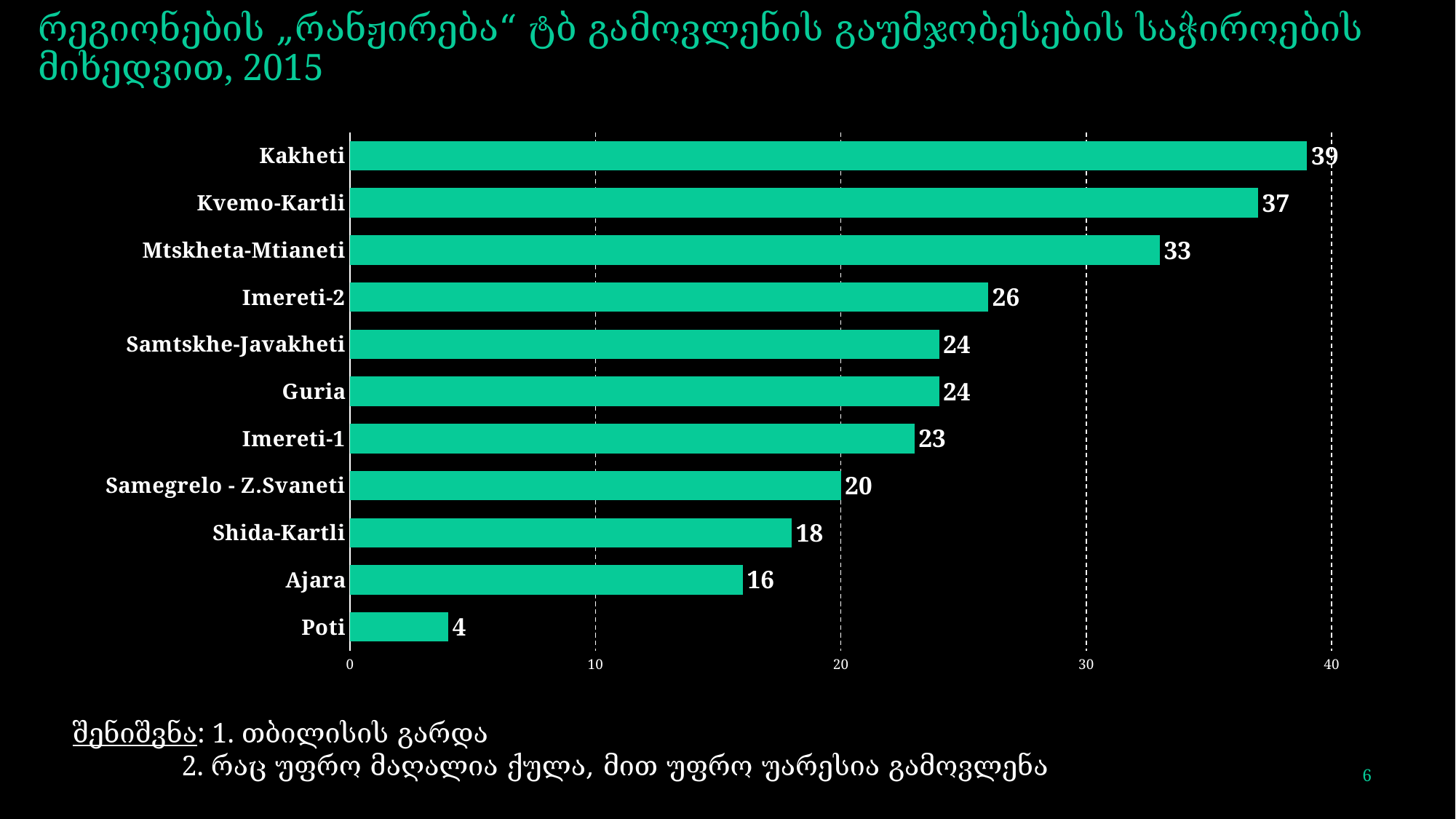
What is the value for Guria? 24 Which region has the highest value? Kakheti What is the difference between the values for Imereti-2 and Imereti-1? 3 What is the value for Kakheti? 39 What is the difference between the values for Kvemo-Kartli and Ajara? 21 Which is larger, the value for Samegrelo - Z.Svaneti or the value for Ajara? Samegrelo - Z.Svaneti What kind of chart is shown on the slide? bar chart Which region has the lowest value? Poti What is the value for Shida-Kartli? 18 How many regions are shown in the chart? 11 What is the value for Mtskheta-Mtianeti? 33 Is the value for Mtskheta-Mtianeti greater or less than 30? greater